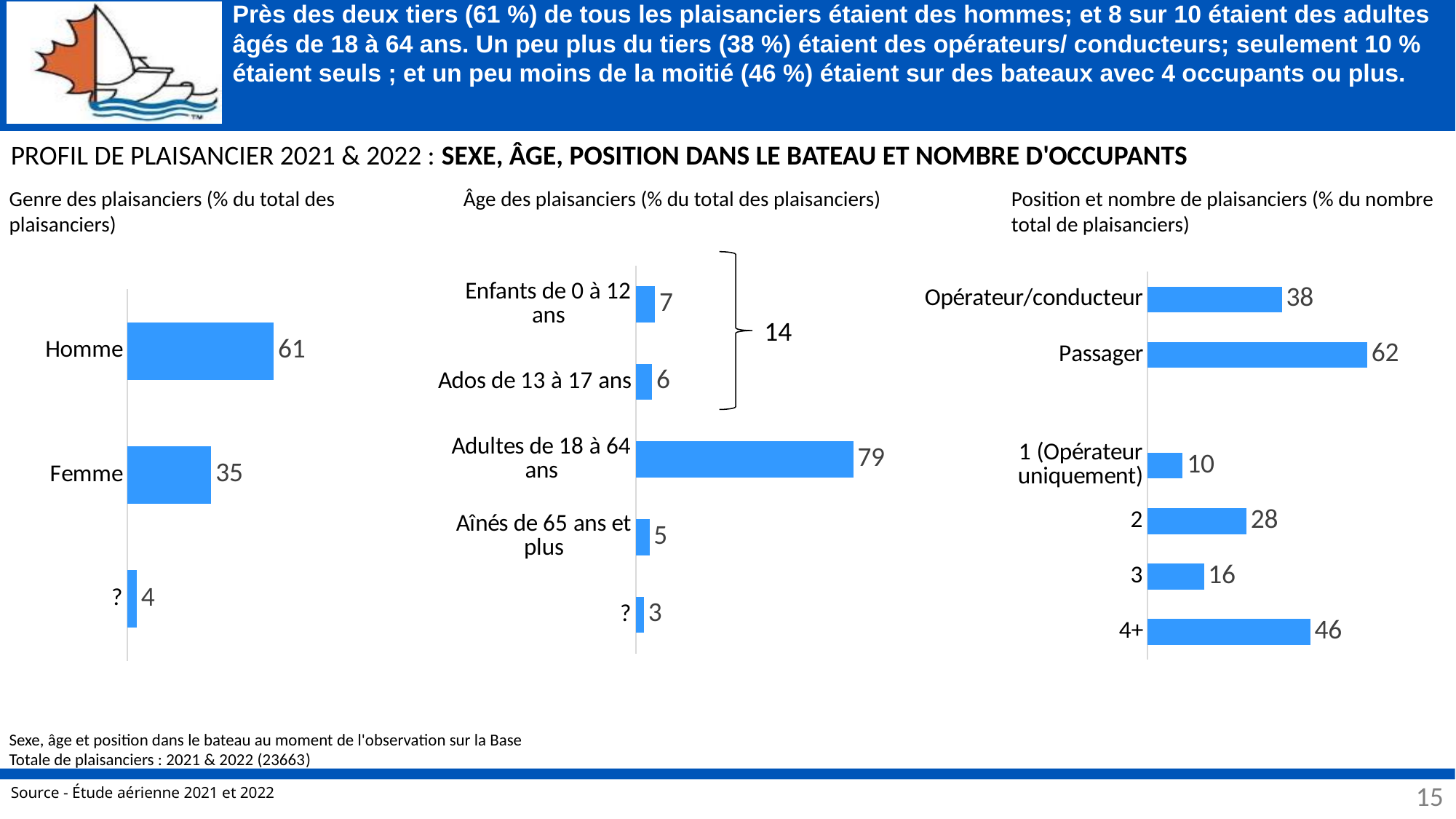
In the 'Genre des plaisanciers' chart, how many categories are shown? 3 In the 'Position et nombre de plaisanciers' chart, what is the value for 4+? 46 In the 'Âge des plaisanciers' chart, which category has the highest value? Adultes de 18 à 64 ans In the 'Âge des plaisanciers' chart, what combined value is shown by the bracket grouping Enfants de 0 à 12 ans and Ados de 13 à 17 ans? 14 In the 'Âge des plaisanciers' chart, which is larger, the value for Enfants de 0 à 12 ans or Ados de 13 à 17 ans? Enfants de 0 à 12 ans In the 'Position et nombre de plaisanciers' chart, what is the value for Passager? 62 In the 'Position et nombre de plaisanciers' chart, which category has the lowest value? 1 (Opérateur uniquement) In the 'Genre des plaisanciers' chart, what is the difference between the values for Homme and Femme? 26 In the 'Position et nombre de plaisanciers' chart, what is the difference between the values for Passager and Opérateur/conducteur? 24 In the 'Âge des plaisanciers' chart, what is the value for Aînés de 65 ans et plus? 5 In the 'Genre des plaisanciers' chart, what is the value for Homme? 61 What type of chart is the 'Genre des plaisanciers' chart? Bar chart